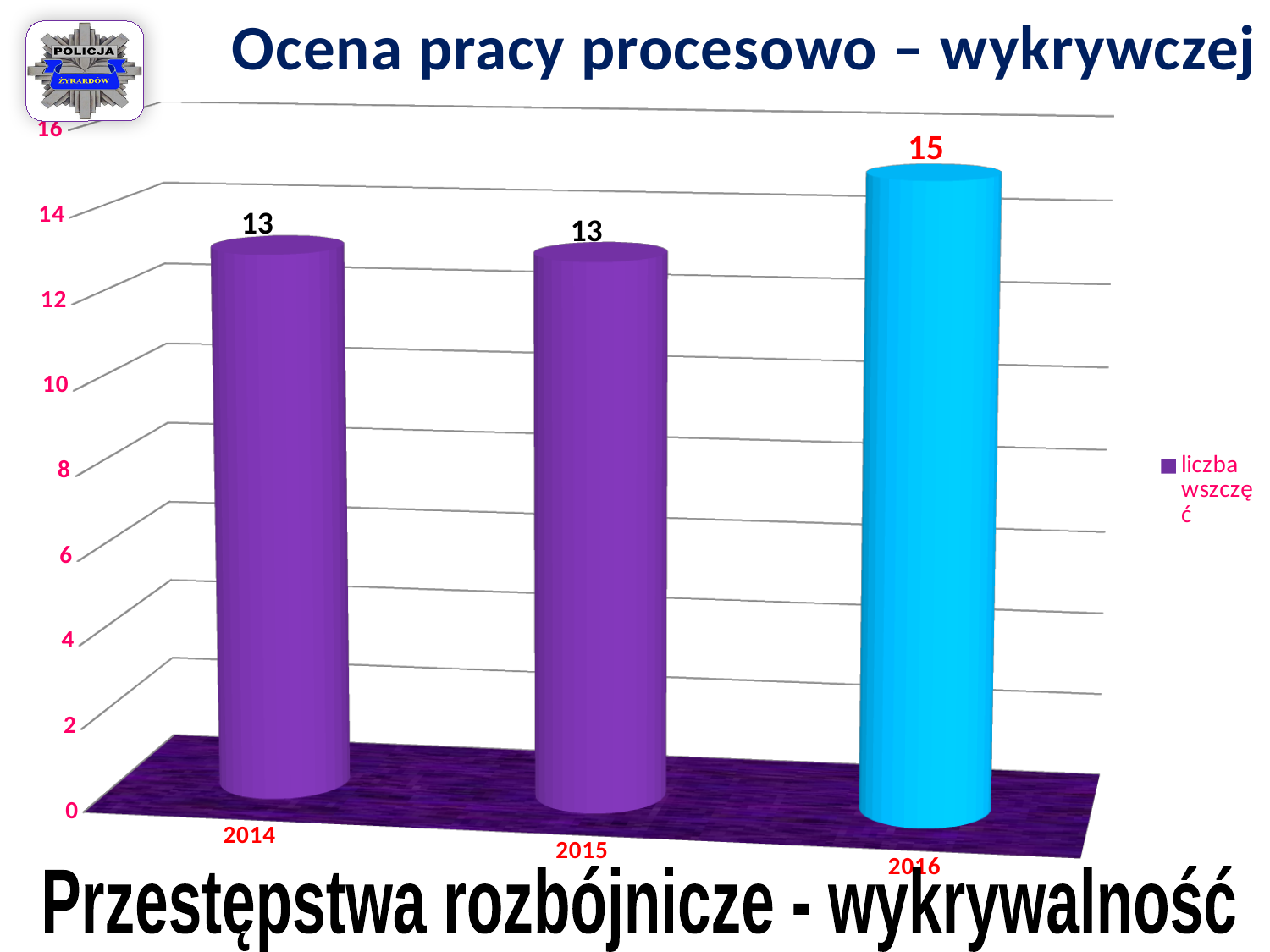
How many years are shown on the x axis? 3 Which year has the highest value? 2016 Is the value for 2016 greater or less than 14? greater What is the value for 2014? 13 What kind of chart is shown on the slide? bar chart What is the value for 2016? 15 Is the value for 2014 greater or less than 14? less What is the name of the series in the legend? liczba wszczęć What is the difference between the values for 2016 and 2015? 2 How many series does the legend list? 1 Which is larger, the value for 2016 or the value for 2014? 2016 What is the value for 2015? 13